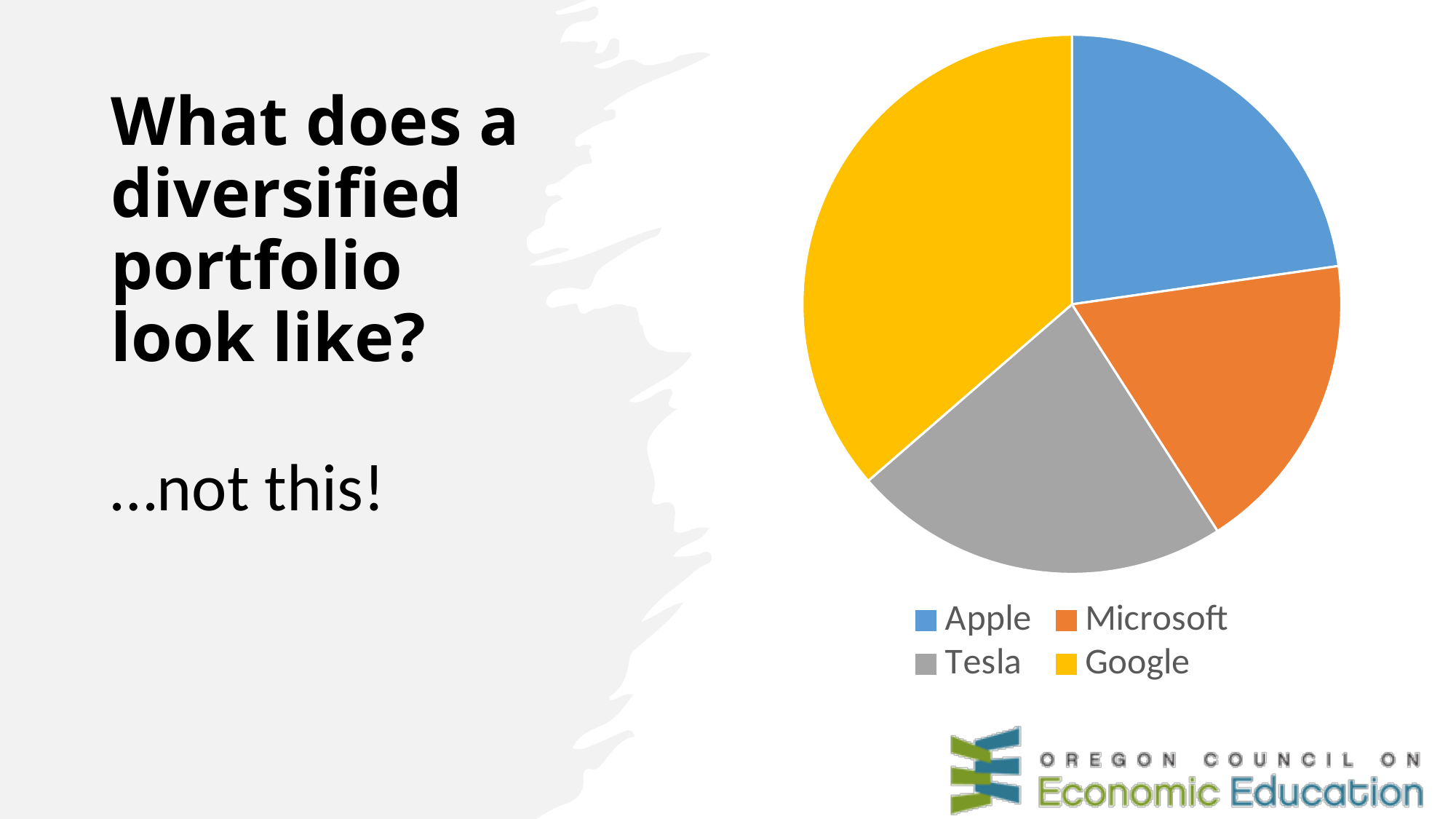
What colour is the Google slice in the pie chart? yellow How many entries does the legend of the pie chart list? 4 Which company has the largest slice of the pie chart? Google Which company is represented by the blue slice in the pie chart? Apple Which slice is larger in the pie chart, Google or Microsoft? Google Which slice is larger in the pie chart, Google or Apple? Google What kind of chart is shown on the slide? pie chart Which company has the smallest slice of the pie chart? Microsoft Which slice is larger in the pie chart, Tesla or Microsoft? Tesla How many slices does the pie chart have? 4